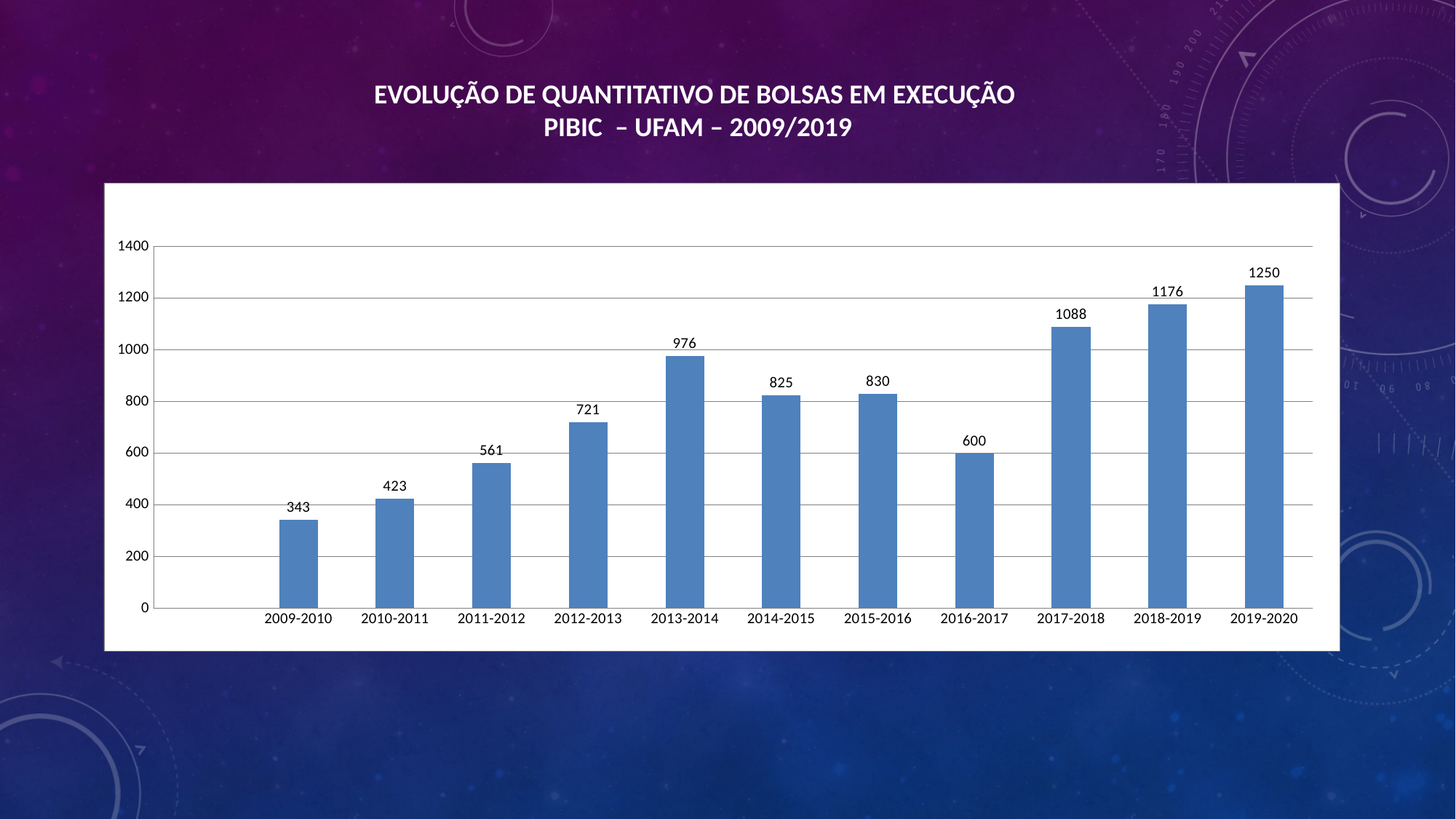
How many periods are shown on the x axis? 11 Which period has the lowest value? 2009-2010 What is the difference between the values for 2013-2014 and 2016-2017? 376 Which period has the highest value? 2019-2020 What is the value for 2013-2014? 976 What is the difference between the values for 2019-2020 and 2018-2019? 74 What kind of chart is shown on the slide? bar chart What is the value for 2009-2010? 343 Which is larger, the value for 2012-2013 or the value for 2014-2015? 2014-2015 Is the value for 2017-2018 greater or less than 1000? greater Do the values rise or fall from 2009-2010 to 2013-2014? rise What is the value for 2016-2017? 600